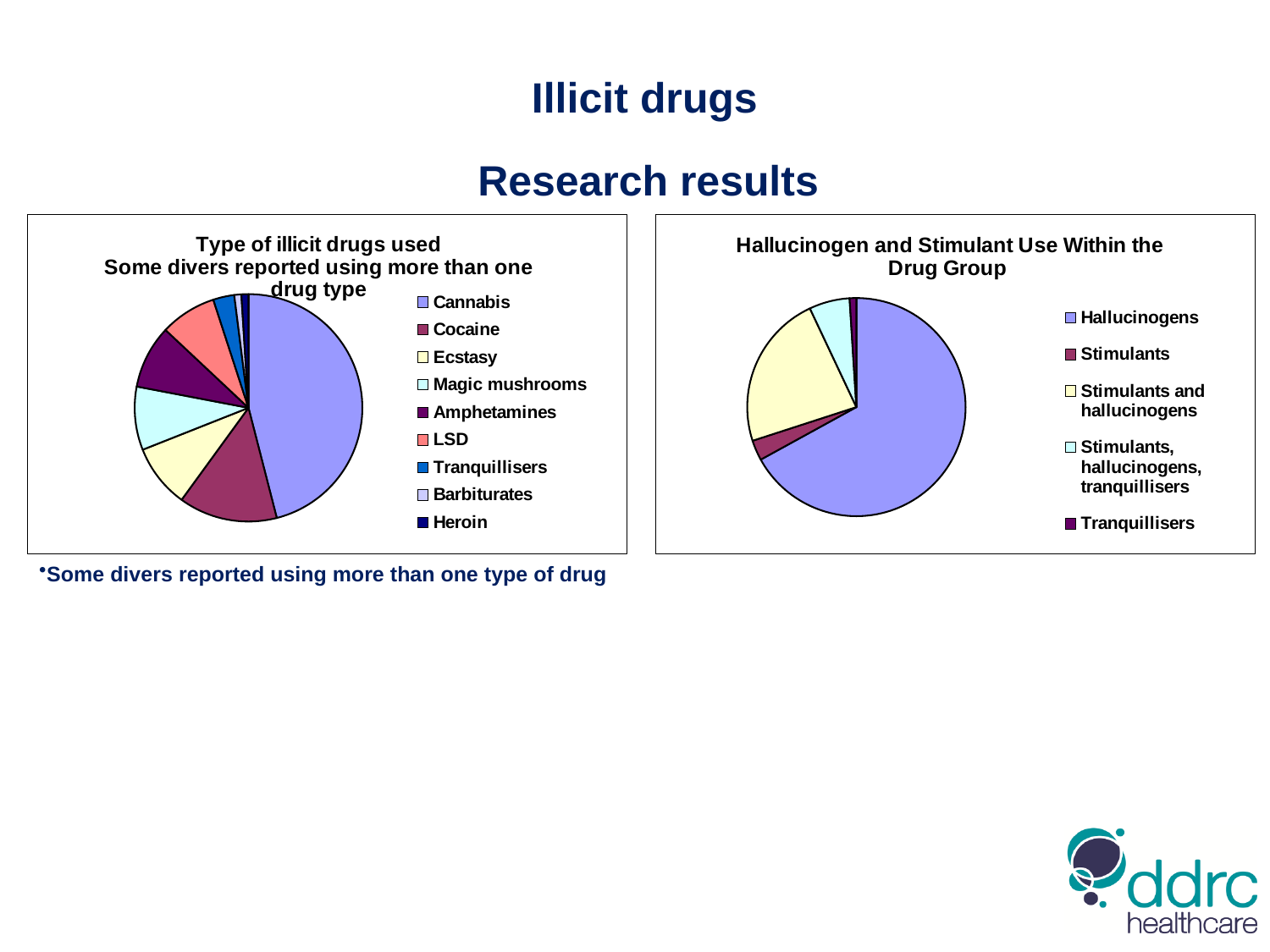
In the chart titled "Type of illicit drugs used", which drug type is the last entry in the legend? Heroin In the chart titled "Hallucinogen and Stimulant Use Within the Drug Group", which category has the largest slice? Hallucinogens What kind of chart is the chart titled "Type of illicit drugs used"? Pie chart In the chart titled "Type of illicit drugs used", which drug type has the largest slice? Cannabis What is the title of the pie chart on the right of the slide? Hallucinogen and Stimulant Use Within the Drug Group In the chart titled "Type of illicit drugs used", which slice is larger, Ecstasy or Tranquillisers? Ecstasy In the chart titled "Hallucinogen and Stimulant Use Within the Drug Group", how many categories are listed in the legend? 5 In the chart titled "Type of illicit drugs used", which slice is larger, Cocaine or LSD? Cocaine In the chart titled "Hallucinogen and Stimulant Use Within the Drug Group", which category has the smallest slice? Tranquillisers What kind of chart is the chart titled "Hallucinogen and Stimulant Use Within the Drug Group"? Pie chart In the chart titled "Hallucinogen and Stimulant Use Within the Drug Group", which slice is larger, Stimulants or Stimulants and hallucinogens? Stimulants and hallucinogens In the chart titled "Type of illicit drugs used", how many drug types are listed in the legend? 9